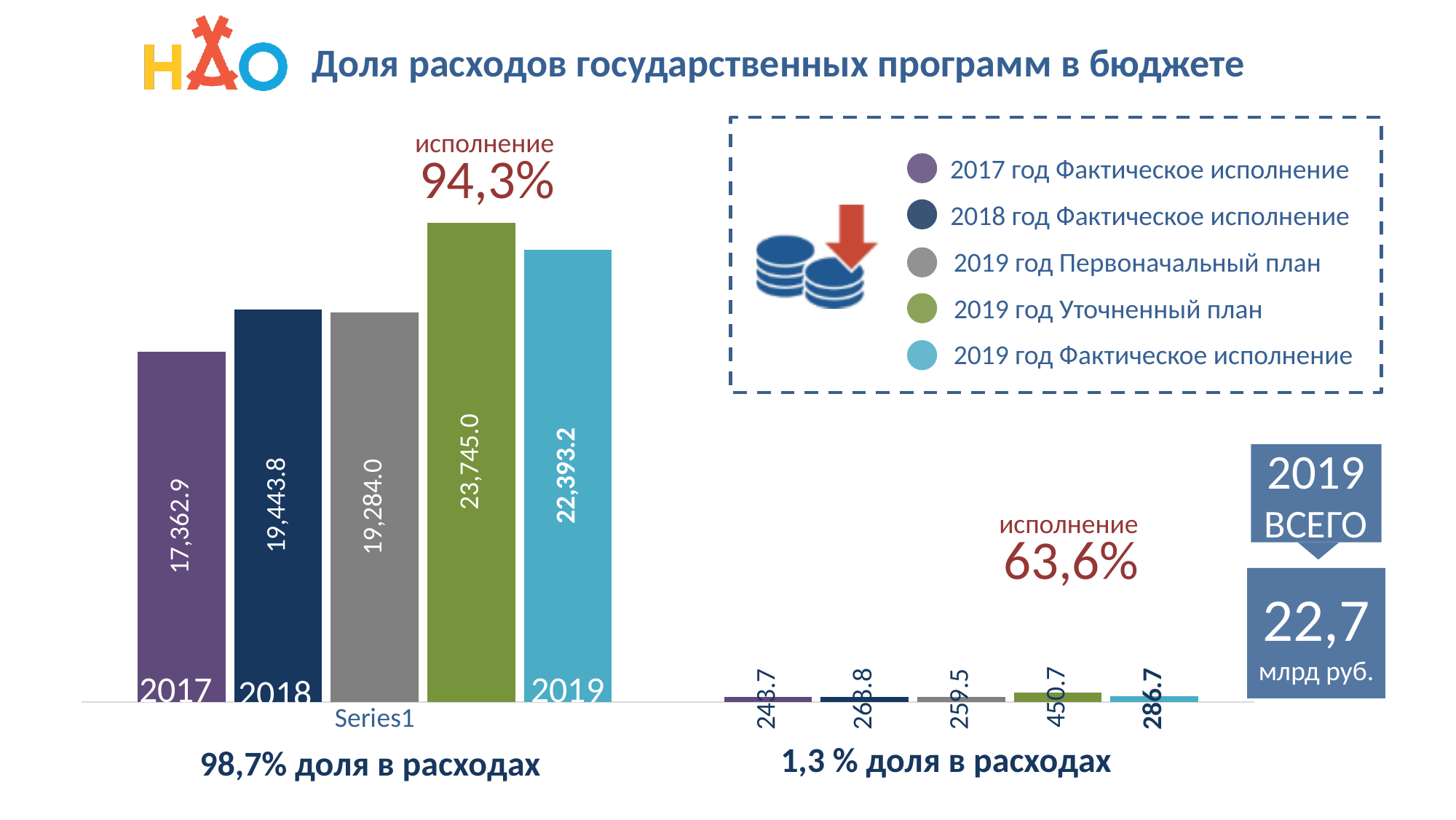
What kind of chart is the left chart (98,7% доля в расходах)? Bar chart In the left chart (98,7% доля в расходах), what is the value for 2017 год Фактическое исполнение? 17,362.9 In the left chart (98,7% доля в расходах), which series has the highest value? 2019 год Уточненный план In the right chart (1,3 % доля в расходах), what is the difference between 2019 год Уточненный план and 2019 год Фактическое исполнение? 164.0 In the left chart (98,7% доля в расходах), what is the value for 2019 год Фактическое исполнение? 22,393.2 In the right chart (1,3 % доля в расходах), what is the value for 2019 год Уточненный план? 450.7 In the right chart (1,3 % доля в расходах), which series has the lowest value? 2017 год Фактическое исполнение How many series does the legend list? 5 In the right chart (1,3 % доля в расходах), what is the value for 2019 год Фактическое исполнение? 286.7 In the left chart (98,7% доля в расходах), which series has the lowest value? 2017 год Фактическое исполнение In the left chart (98,7% доля в расходах), what is the difference between 2019 год Уточненный план and 2019 год Фактическое исполнение? 1,351.8 In the left chart (98,7% доля в расходах), what is the value for 2019 год Уточненный план? 23,745.0